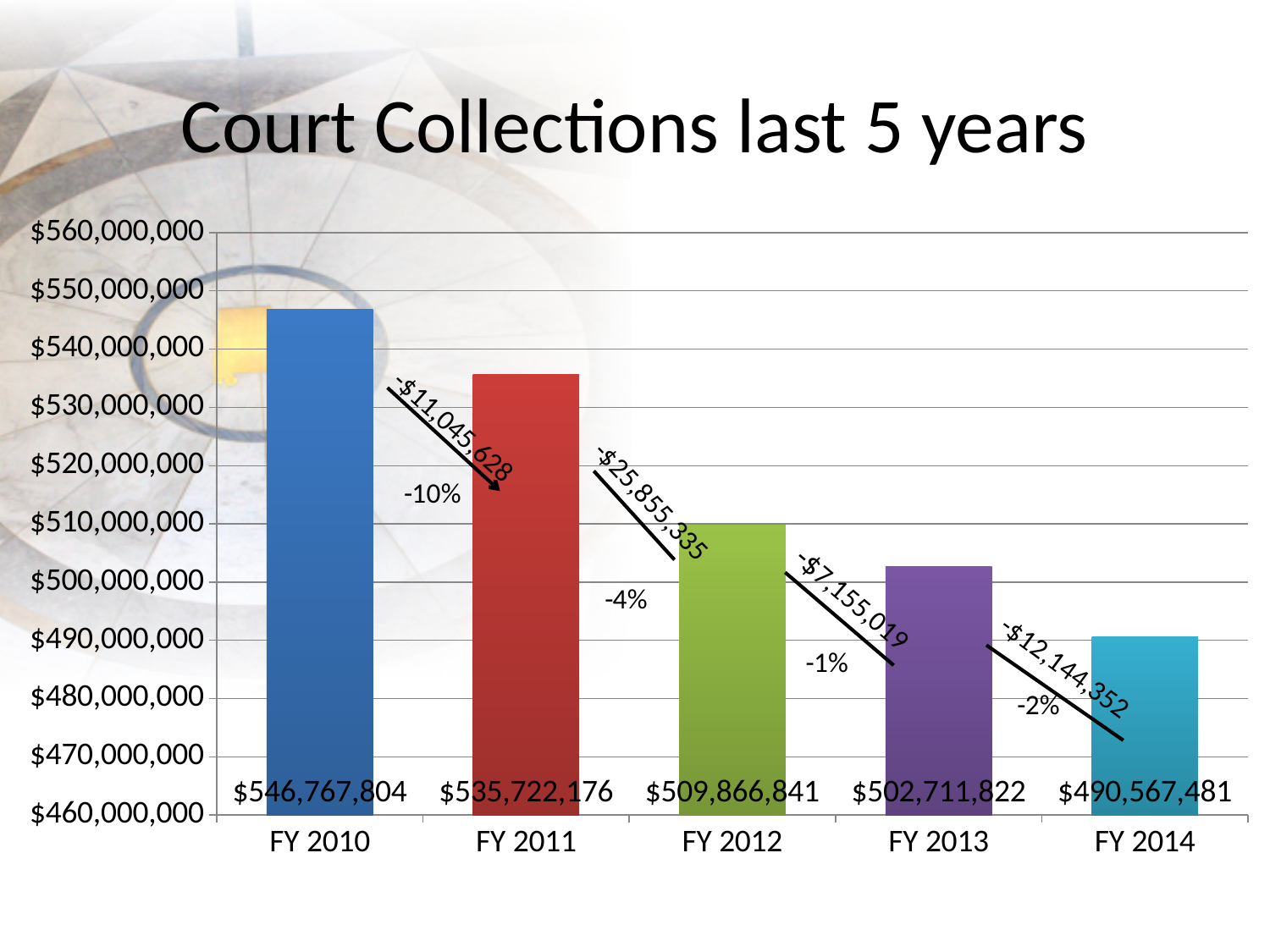
Is the value for FY 2011 greater or less than $530,000,000? greater What is the value for FY 2010? $546,767,804 What is the difference between the FY 2010 and FY 2011 values? $11,045,628 What is the difference between the FY 2013 and FY 2014 values? $12,144,352 What is the value for FY 2014? $490,567,481 Which is larger, the value for FY 2012 or the value for FY 2013? FY 2012 How many fiscal years are shown on the chart? 5 What kind of chart is shown on the slide? bar chart Do the values rise or fall from FY 2010 to FY 2014? fall What is the value for FY 2012? $509,866,841 Which fiscal year has the lowest court collections? FY 2014 Which fiscal year has the highest court collections? FY 2010